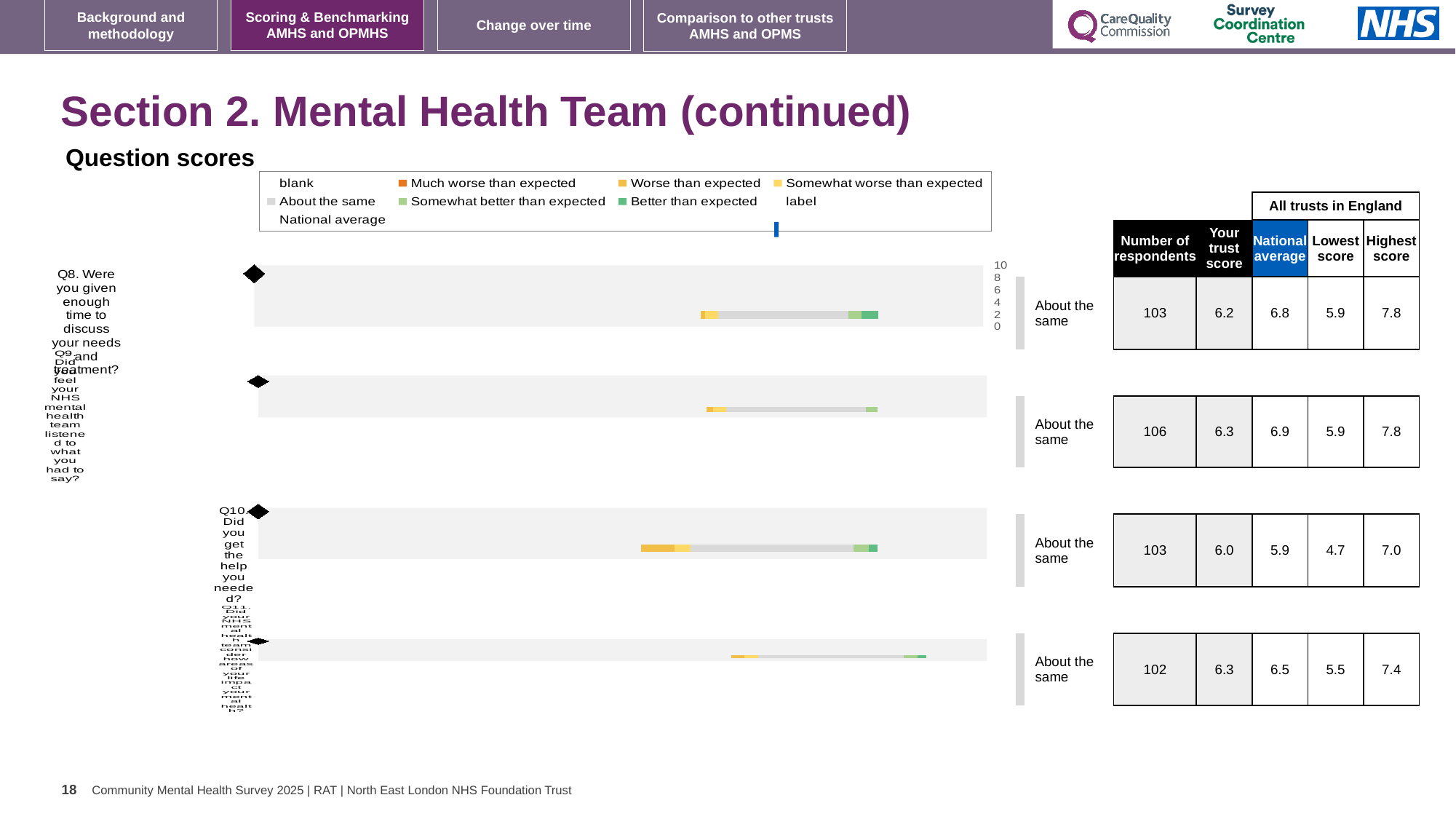
In the legend, what colour represents 'Much worse than expected'? orange In the legend, what colour represents 'Better than expected'? green How many question-score bar charts are shown on the slide? 4 What kind of chart is used for the question scores on this slide? bar chart For the Q9 chart (did your NHS mental health team listen to what you had to say), what is the number of respondents? 106 What is the difference between the national average and the trust score for the Q8 chart? 0.6 For the Q11 chart (did your team consider how areas of your life impact your mental health), what is the highest score among all trusts in England? 7.4 For the Q8 chart (enough time to discuss your needs and treatment), what is the 'Your trust score' shown in the table? 6.2 What comparison category is shown next to each of the four question charts? About the same Which question chart has the highest 'Your trust score' in the table: Q8 or Q10? Q8 For the Q10 chart, what is the lowest score among all trusts in England? 4.7 For the Q10 chart (did you get the help you needed), what is the national average score? 5.9